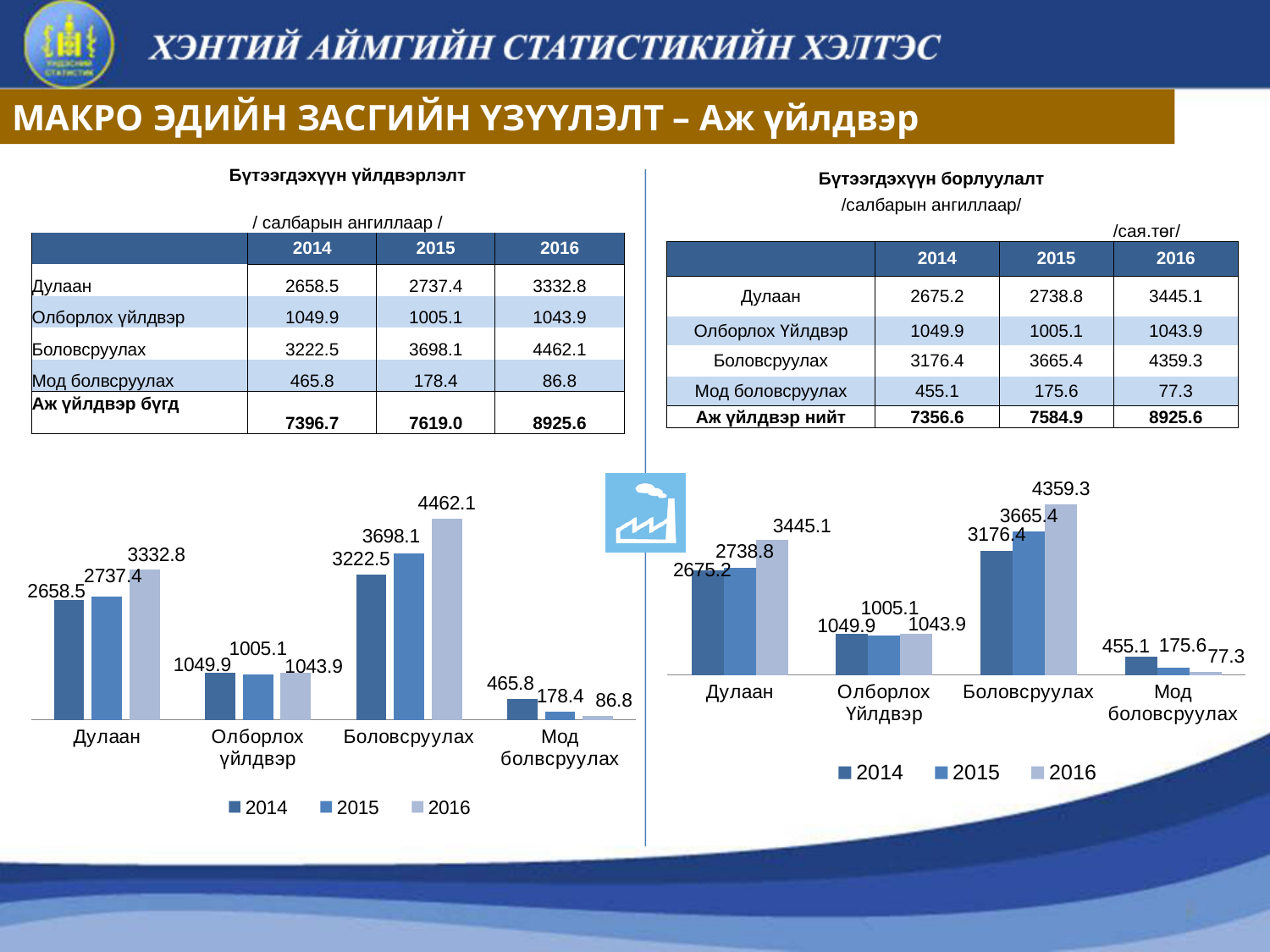
How many categories are shown on the x axis of the left chart (Бүтээгдэхүүн үйлдвэрлэлт)? 4 How many series does the legend of the right chart (Бүтээгдэхүүн борлуулалт) list? 3 In the right chart (Бүтээгдэхүүн борлуулалт), how do the values for Мод боловсруулах change from 2014 to 2016? They fall In the right chart (Бүтээгдэхүүн борлуулалт), what is the value for Дулаан in 2014? 2675.2 In the left chart (Бүтээгдэхүүн үйлдвэрлэлт), which is larger for Олборлох үйлдвэр: the 2014 value or the 2015 value? 2014 In the left chart (Бүтээгдэхүүн үйлдвэрлэлт), what is the difference between the 2016 and 2014 values for Дулаан? 674.3 What type of chart is the right chart (Бүтээгдэхүүн борлуулалт)? Bar chart In the left chart (Бүтээгдэхүүн үйлдвэрлэлт), what is the value for Боловсруулах in 2016? 4462.1 In the right chart (Бүтээгдэхүүн борлуулалт), what is the difference between the 2014 and 2016 values for Мод боловсруулах? 377.8 In the right chart (Бүтээгдэхүүн борлуулалт), which category has the highest value in 2016? Боловсруулах In the left chart (Бүтээгдэхүүн үйлдвэрлэлт), which category has the lowest value in 2016? Мод болвсруулах What are the legend entries of the left chart (Бүтээгдэхүүн үйлдвэрлэлт)? 2014, 2015, 2016